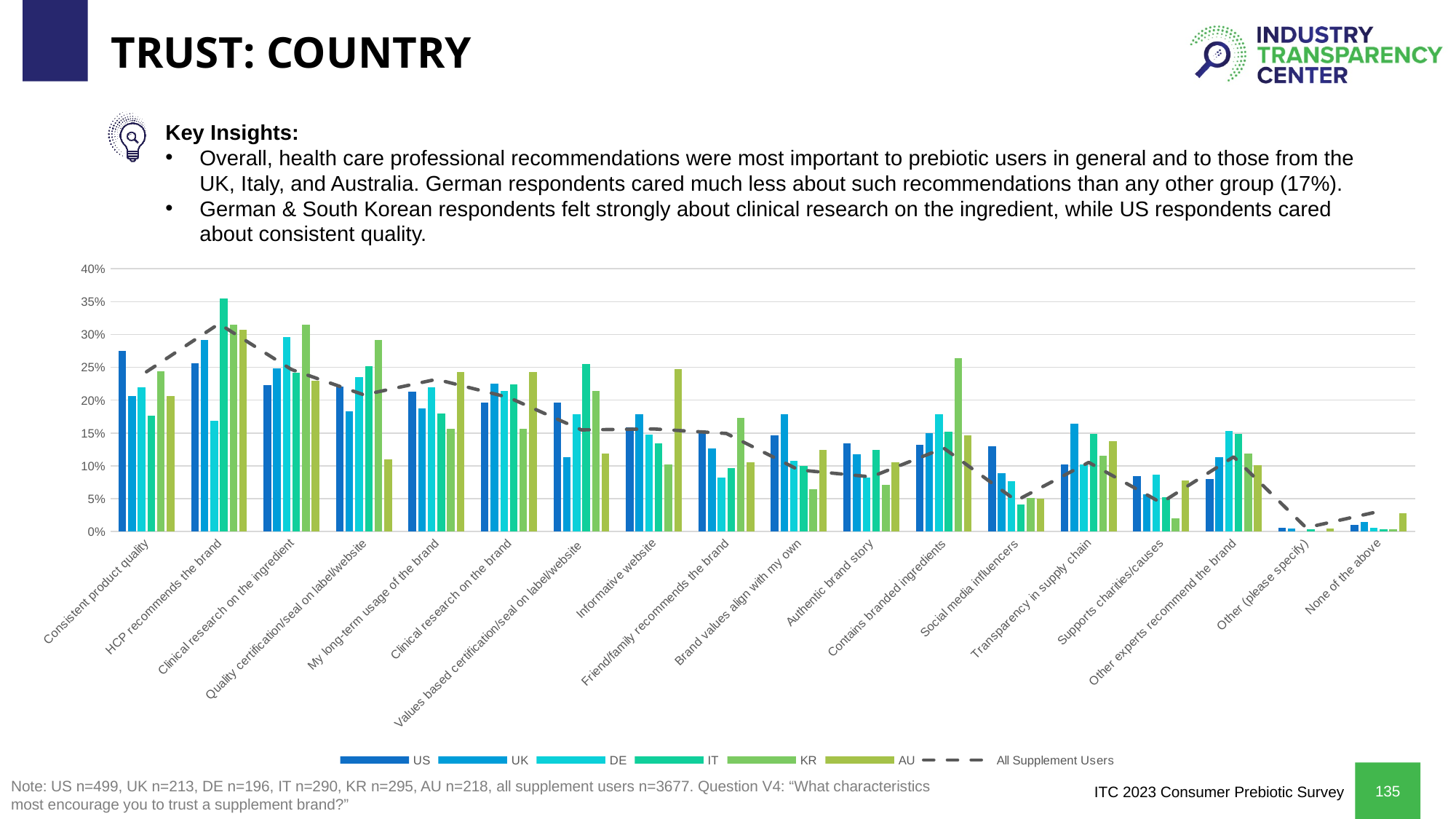
Is the DE value for 'Clinical research on the ingredient' greater or less than 25%? greater Which legend entry is drawn as a dashed line rather than bars? All Supplement Users Is the IT value for 'HCP recommends the brand' greater or less than 30%? greater For 'Consistent product quality', which is larger: the US value or the DE value? US How many entries does the chart's legend list? 7 Which country has the lowest value for 'HCP recommends the brand'? DE Which country has the highest value for 'HCP recommends the brand'? IT Which country has the highest value for 'Contains branded ingredients'? KR Which country has the highest value for 'Informative website'? AU What kind of chart is shown on the slide? combination bar and line chart Is the DE value for 'Social media influencers' greater or less than 10%? less How many categories are shown along the x axis of the chart? 18